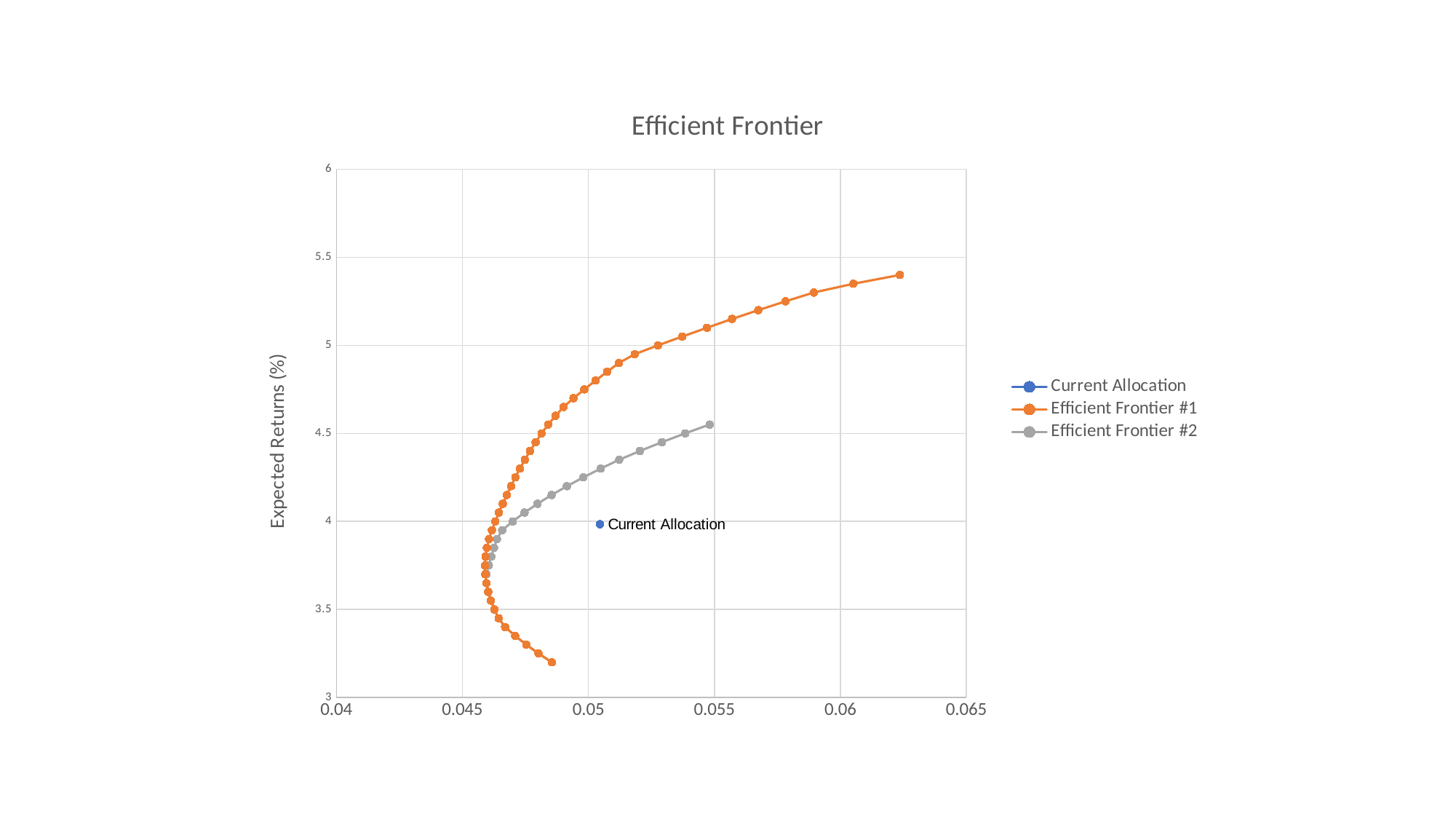
Is the lowest expected return on Efficient Frontier #1 greater or less than 3.5? less What kind of chart is shown on the slide? scatter chart Is the highest expected return reached by Efficient Frontier #1 greater or less than 5? greater Is the highest expected return reached by Efficient Frontier #2 greater or less than 5? less How many series does the legend list? 3 Which series reaches a higher expected return, Efficient Frontier #1 or Efficient Frontier #2? Efficient Frontier #1 What is the title of the chart? Efficient Frontier What is the label on the vertical axis? Expected Returns (%)